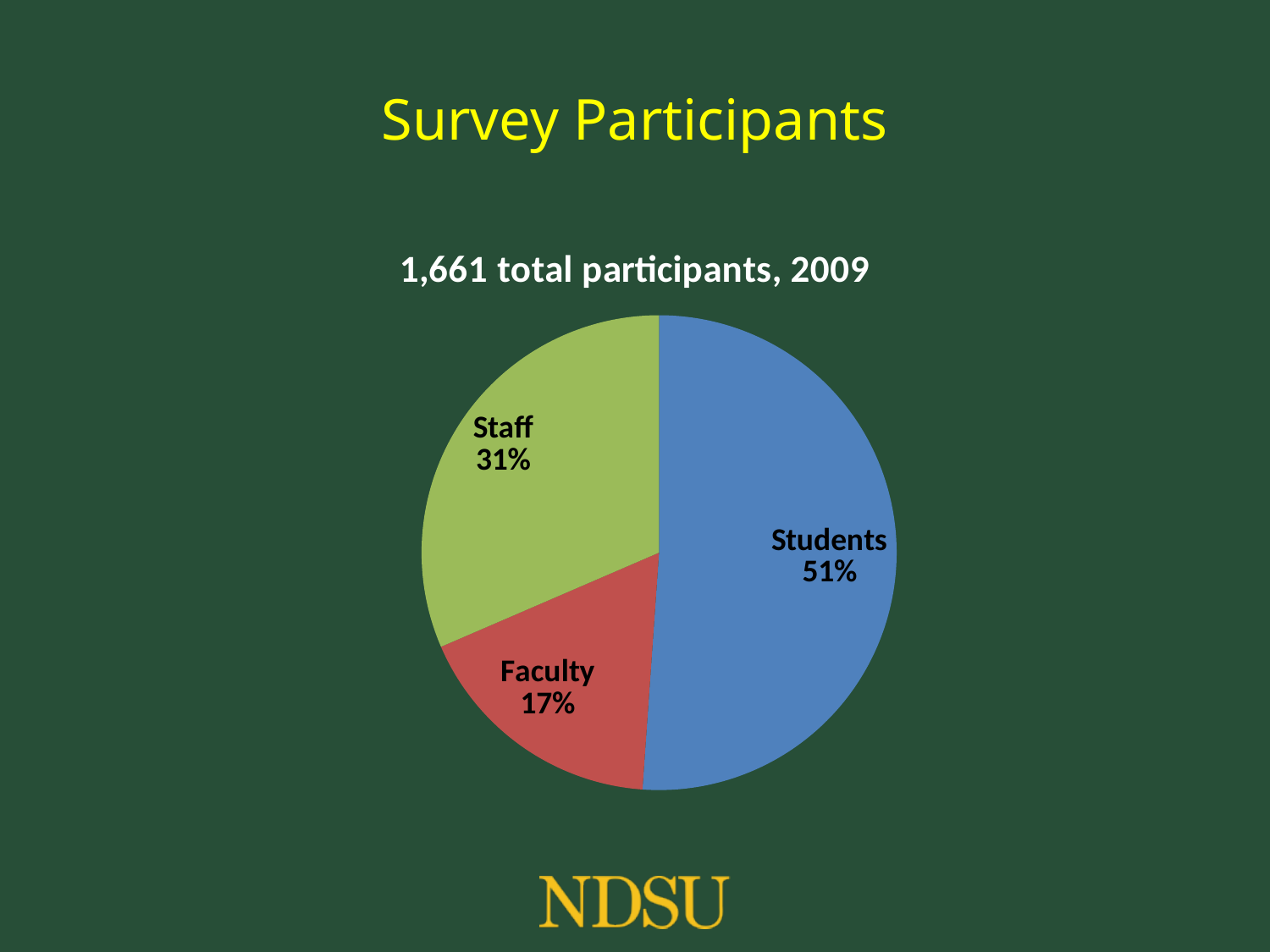
What kind of chart is shown on the slide? pie chart What share of survey participants are Faculty? 17% Which group has the smallest share of the pie? Faculty What is the difference in percentage points between the Staff and Faculty shares? 14 Which is larger, the Staff share or the Faculty share? Staff Which group has the largest share of the pie? Students What share of survey participants are Staff? 31% What is the chart's title? 1,661 total participants, 2009 What share of survey participants are Students? 51% How many slices does the pie chart have? 3 What is the difference in percentage points between the Students and Staff shares? 20 What colour is the Students slice? blue